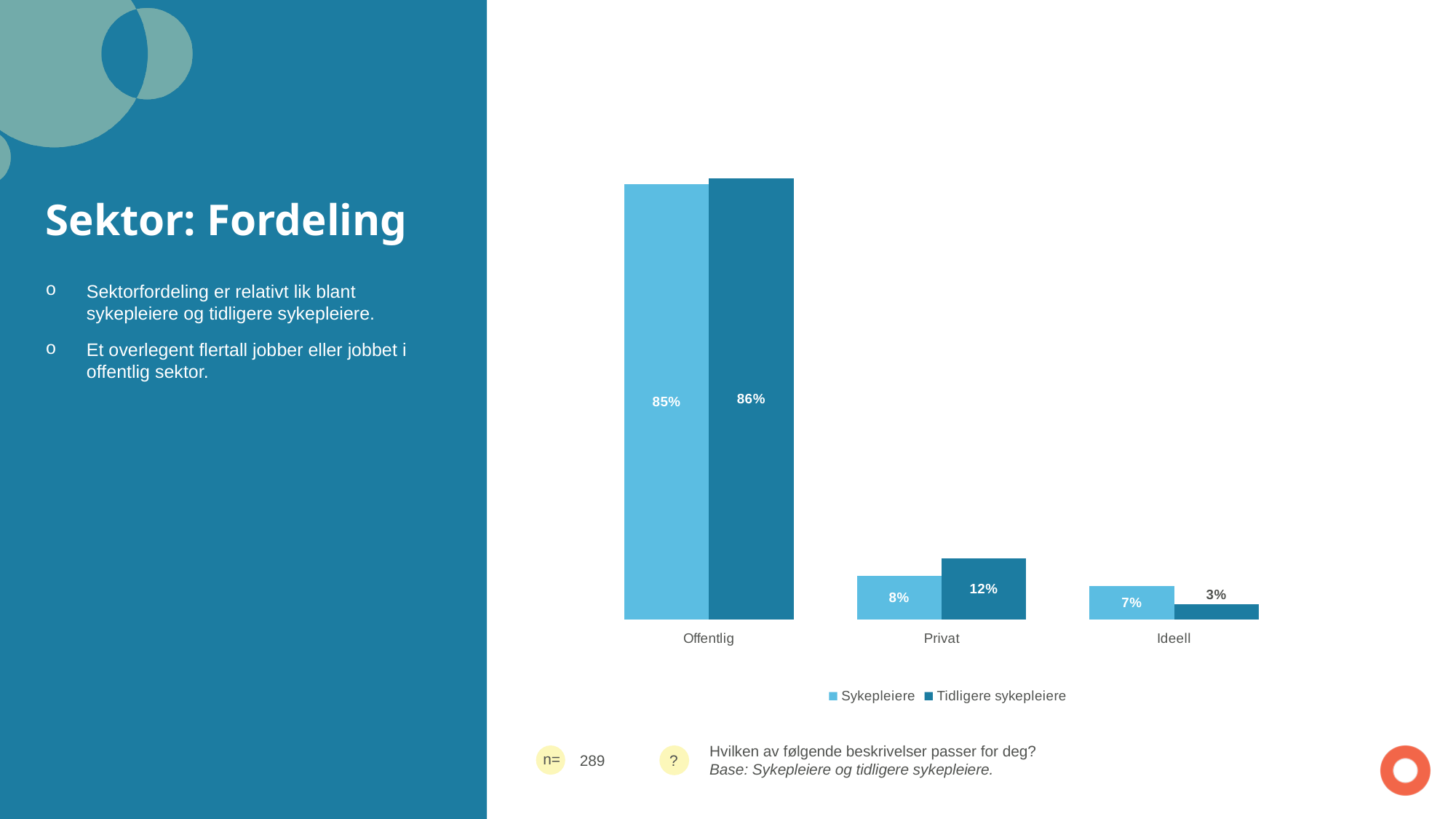
What is the value for Tidligere sykepleiere in the Ideell category? 3% What is the value for Sykepleiere in the Ideell category? 7% What is the value for Tidligere sykepleiere in the Privat category? 12% What kind of chart is shown on the slide? Bar chart How many series does the legend list? 2 Which category has the highest value for Tidligere sykepleiere? Offentlig Which category has the lowest value for Sykepleiere? Ideell In the Ideell category, which series has the larger value, Sykepleiere or Tidligere sykepleiere? Sykepleiere What are the two series named in the legend? Sykepleiere and Tidligere sykepleiere What is the value for Sykepleiere in the Offentlig category? 85% How many categories are shown on the x axis? 3 What is the difference between Tidligere sykepleiere and Sykepleiere in the Privat category? 4%